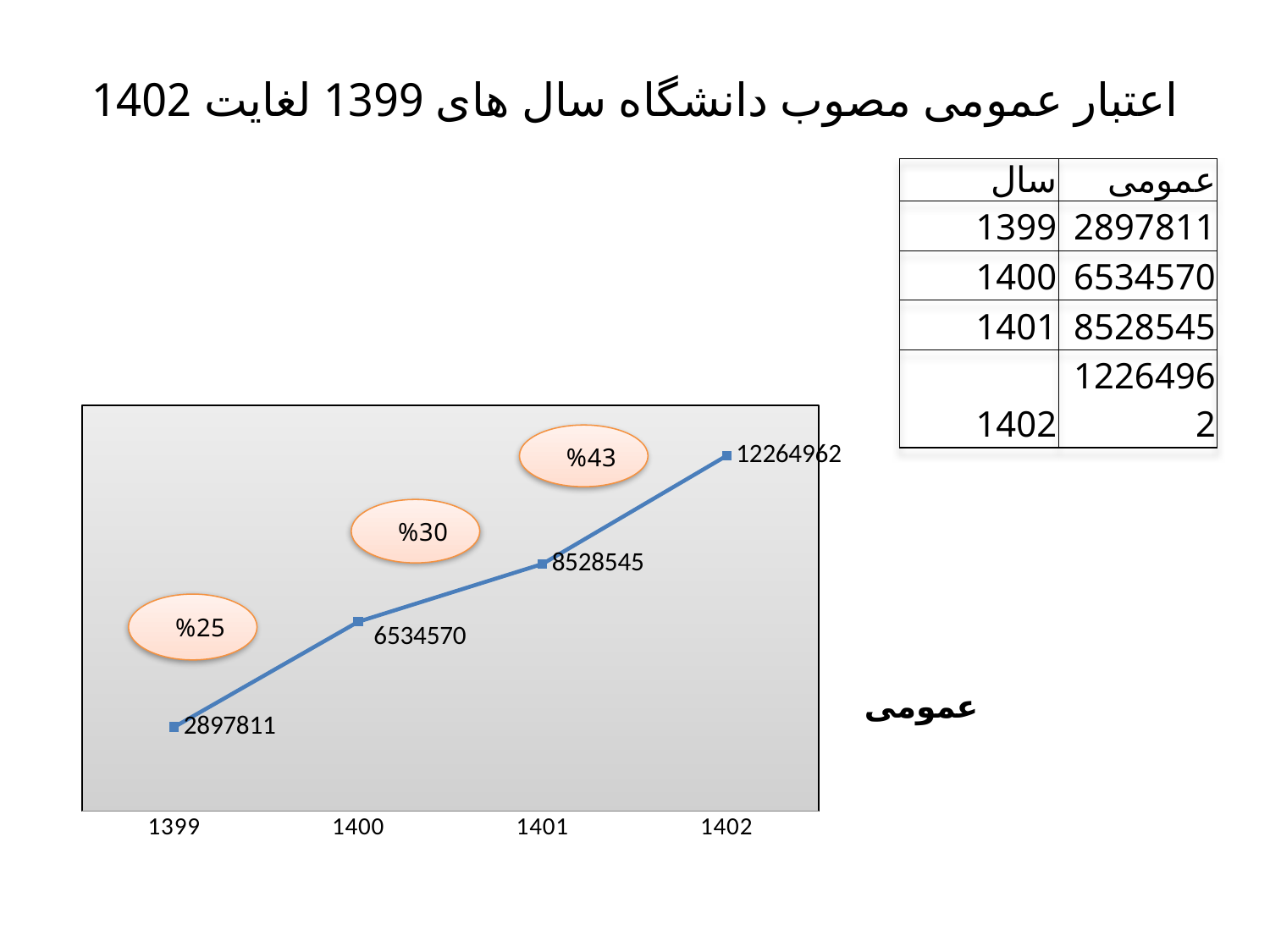
Do the values rise or fall from 1399 to 1402? rise Which year has the highest value? 1402 What is the value for 1402? 12264962 What is the value for 1401? 8528545 What kind of chart is shown? line chart How many years are plotted on the chart? 4 What is the difference between the values for 1400 and 1399? 3636759 What is the difference between the values for 1402 and 1401? 3736417 What is the value for 1400? 6534570 Which is larger, the value for 1400 or the value for 1401? 1401 What is the value for 1399? 2897811 Which year has the lowest value? 1399